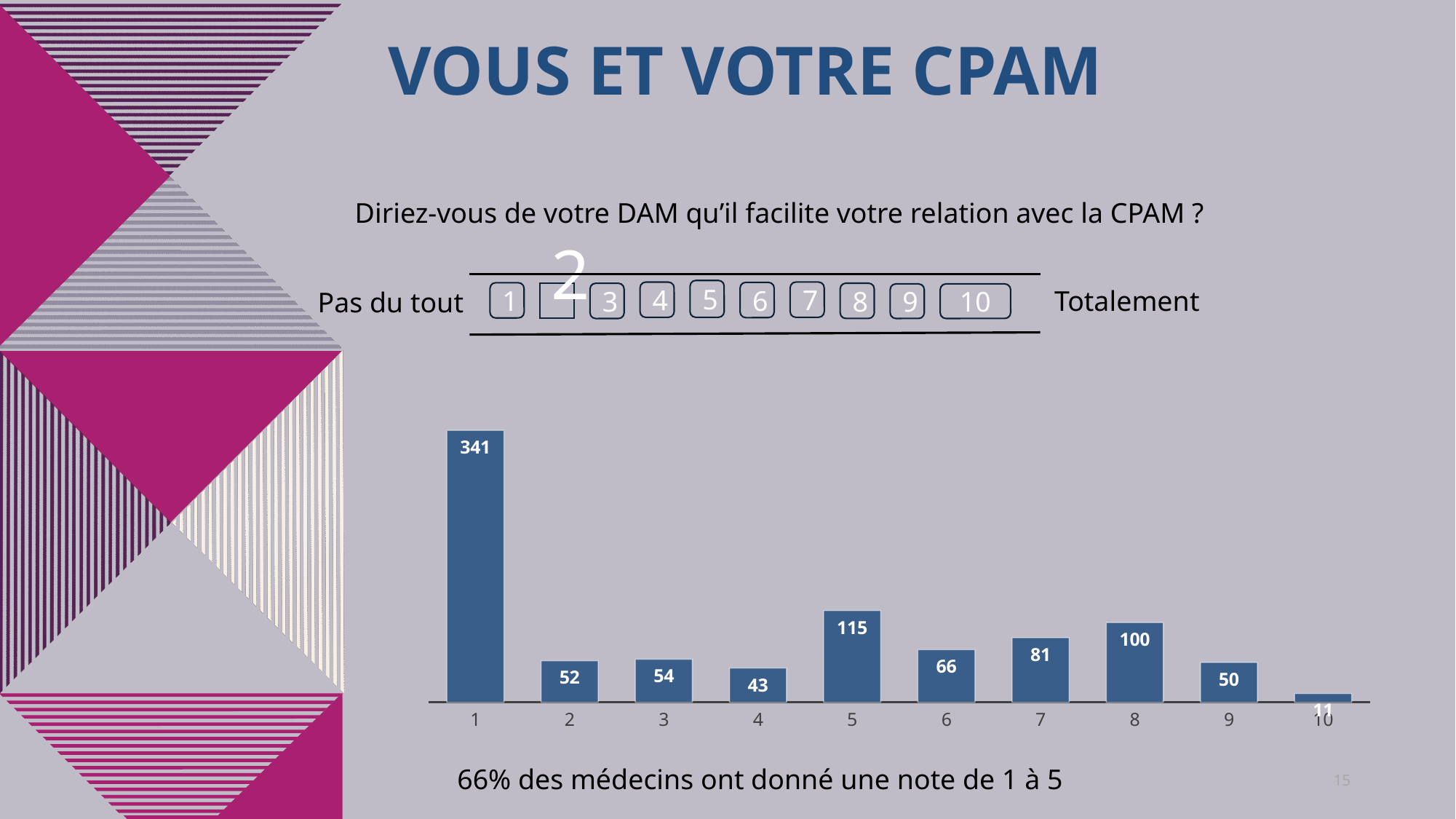
How many rating categories are shown on the x axis? 10 What kind of chart is shown on the slide? bar chart What is the value for rating 8? 100 What is the value for rating 1? 341 What is the value for rating 10? 11 According to the text below the chart, what percentage of doctors gave a rating from 1 to 5? 66% Which rating has the highest value? 1 Which rating has the lowest value? 10 What is the difference between the values for rating 7 and rating 9? 31 What is the value for rating 5? 115 What is the difference between the values for rating 1 and rating 5? 226 Which is larger, the value for rating 2 or the value for rating 6? rating 6